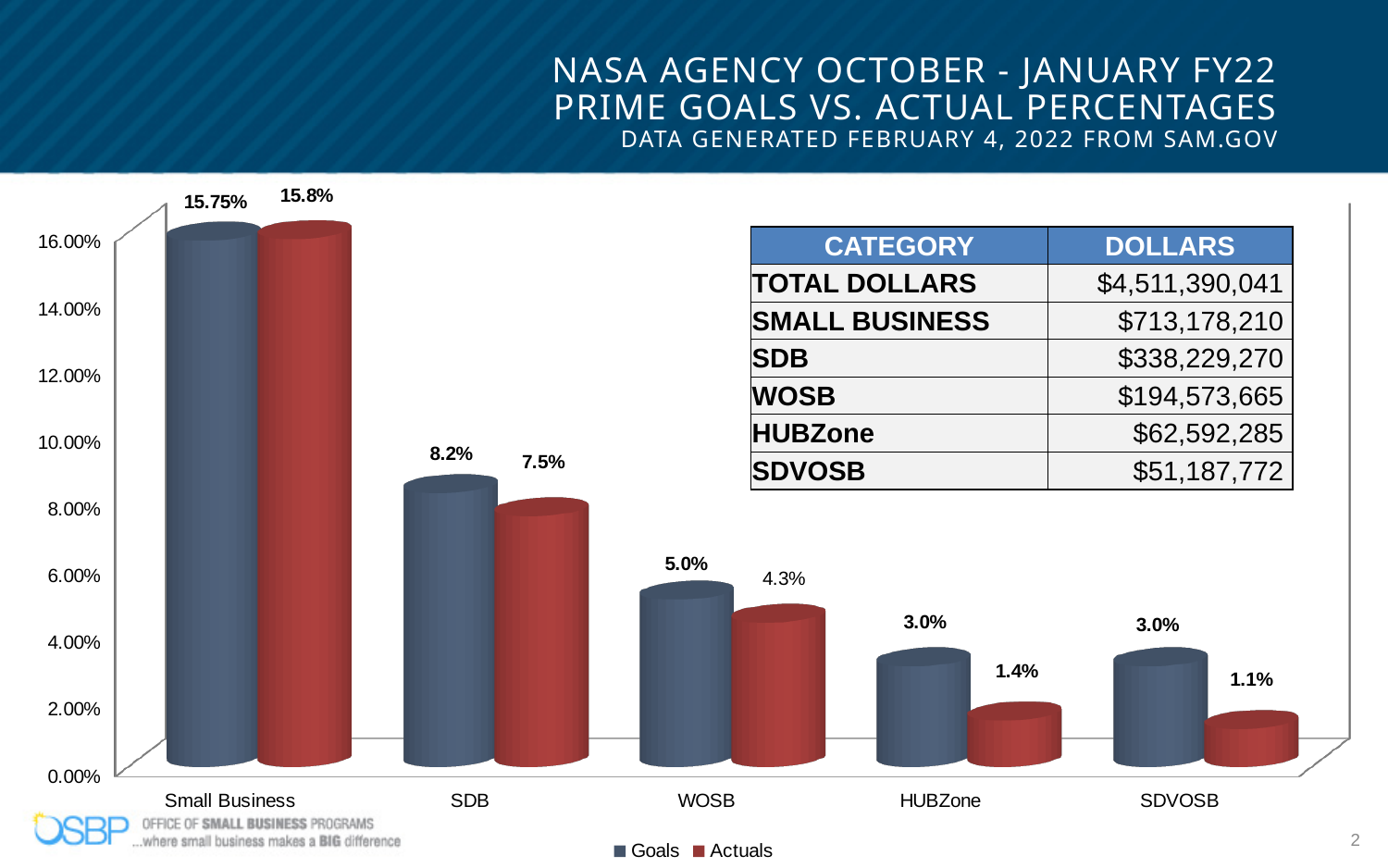
Which category has the lowest Actuals value? SDVOSB Do the Goals values rise or fall from Small Business to SDVOSB along the x axis? Fall How many series does the legend list? 2 Which is larger for WOSB, the Goals value or the Actuals value? Goals What is the Actuals value for HUBZone? 1.4% What is the Goals value for WOSB? 5.0% What is the Goals value for Small Business? 15.75% What kind of chart is shown on the slide? Bar chart What is the difference between the Goals and Actuals values for SDB? 0.7% How many categories are shown on the x axis? 5 What is the Actuals value for SDB? 7.5% Which category has the highest Actuals value? Small Business